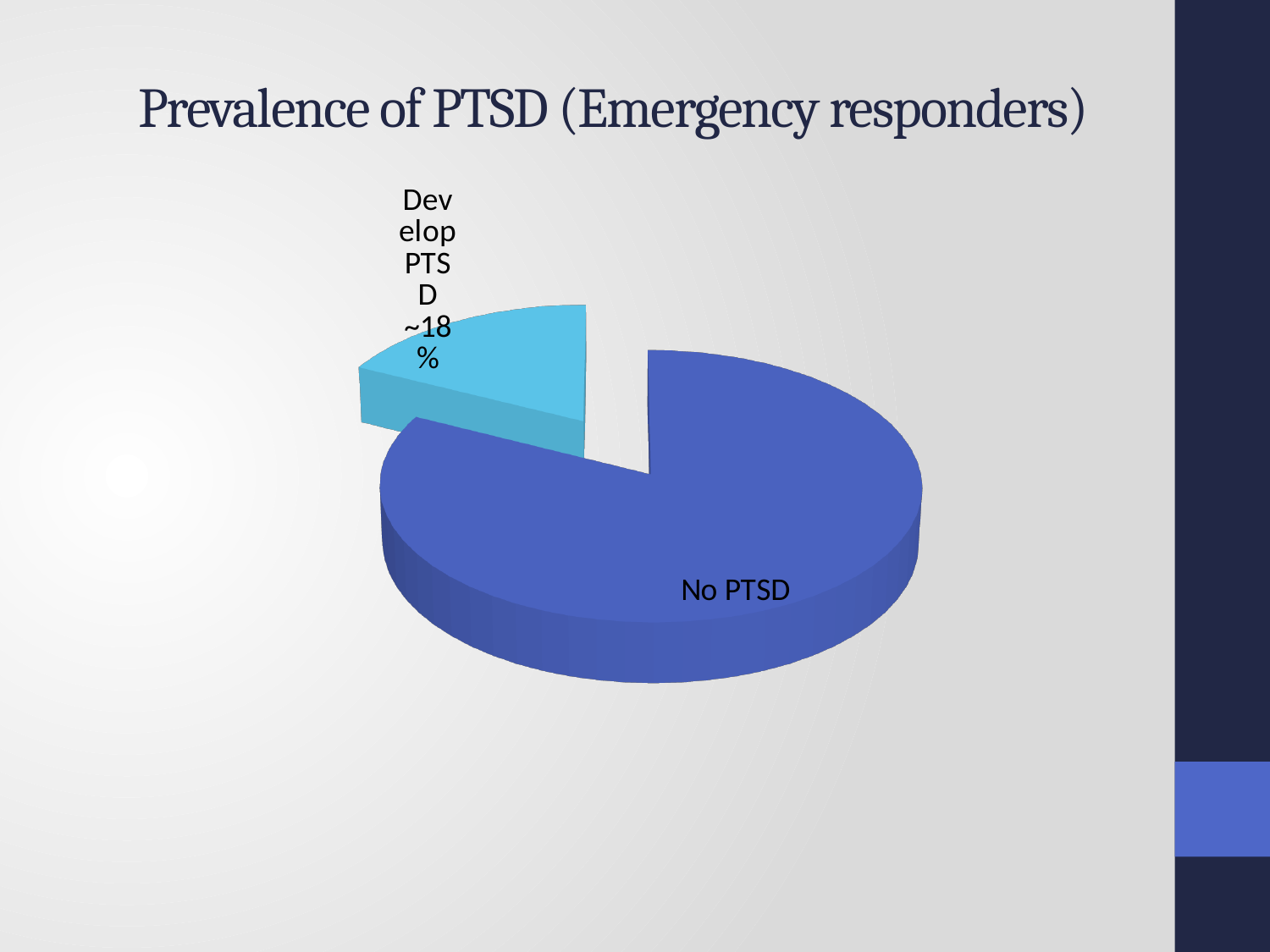
What is the title of the chart on the slide? Prevalence of PTSD (Emergency responders) What kind of chart is shown on the slide? pie chart How many slices does the pie chart have? 2 Is the Develop PTSD slice less than half of the pie? yes Which slice of the pie chart is the smallest? Develop PTSD Which slice of the pie chart is the largest? No PTSD What percentage label is printed on the Develop PTSD slice? ~18% What colour is the No PTSD slice in the pie chart? blue Which is larger in the pie chart, the No PTSD slice or the Develop PTSD slice? No PTSD